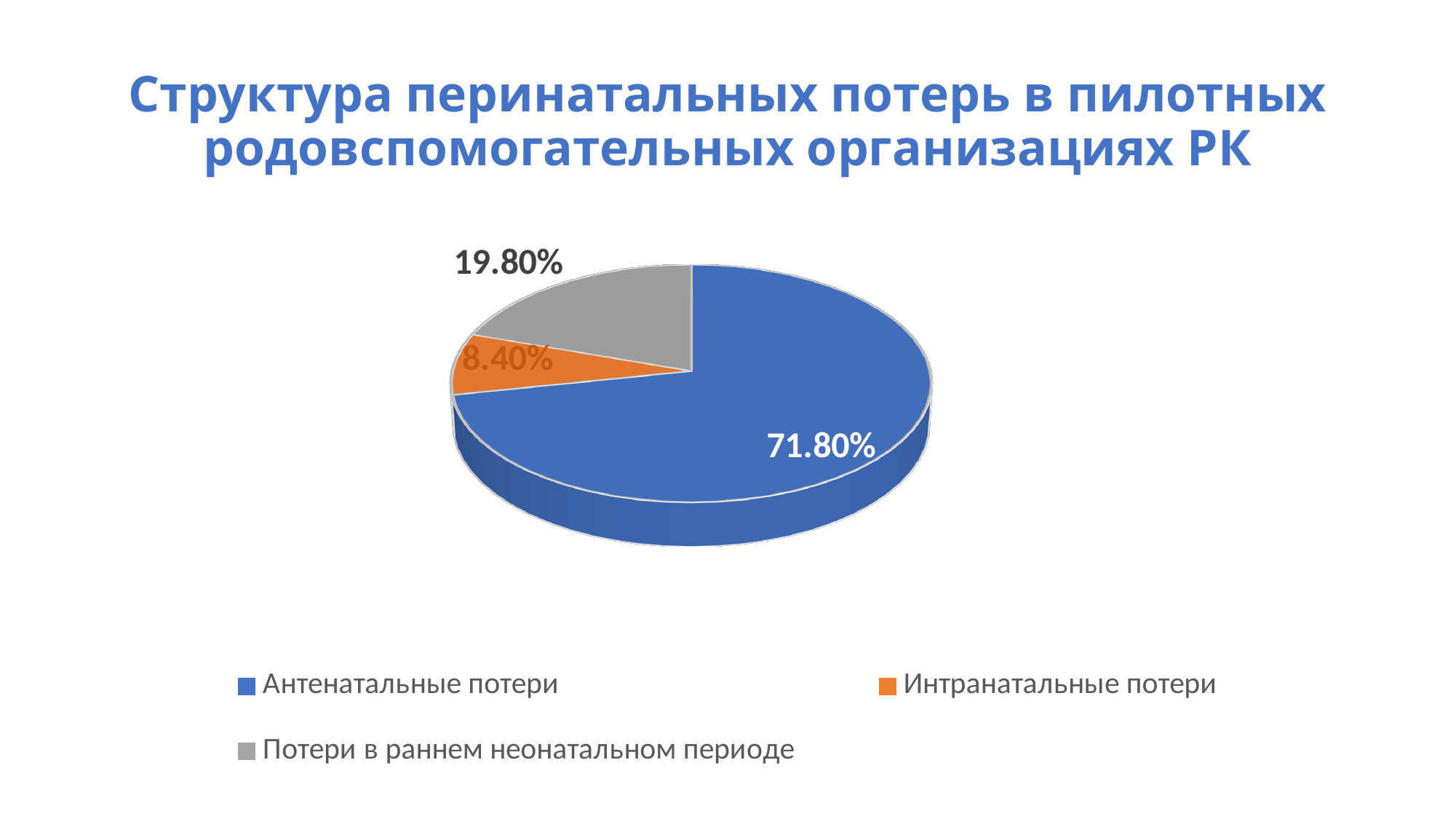
What is the difference between the values for Антенатальные потери and Потери в раннем неонатальном периоде? 52.00% Which category has the largest share of the pie? Антенатальные потери How many categories does the pie chart have? 3 What colour is the slice for Интранатальные потери? Orange What is the title of the chart? Структура перинатальных потерь в пилотных родовспомогательных организациях РК What is the value for Антенатальные потери? 71.80% Which is larger: Потери в раннем неонатальном периоде or Интранатальные потери? Потери в раннем неонатальном периоде What is the value for Потери в раннем неонатальном периоде? 19.80% Which category has the smallest share of the pie? Интранатальные потери What is the value for Интранатальные потери? 8.40% What type of chart is shown on the slide? Pie chart What is the difference between the values for Потери в раннем неонатальном периоде and Интранатальные потери? 11.40%